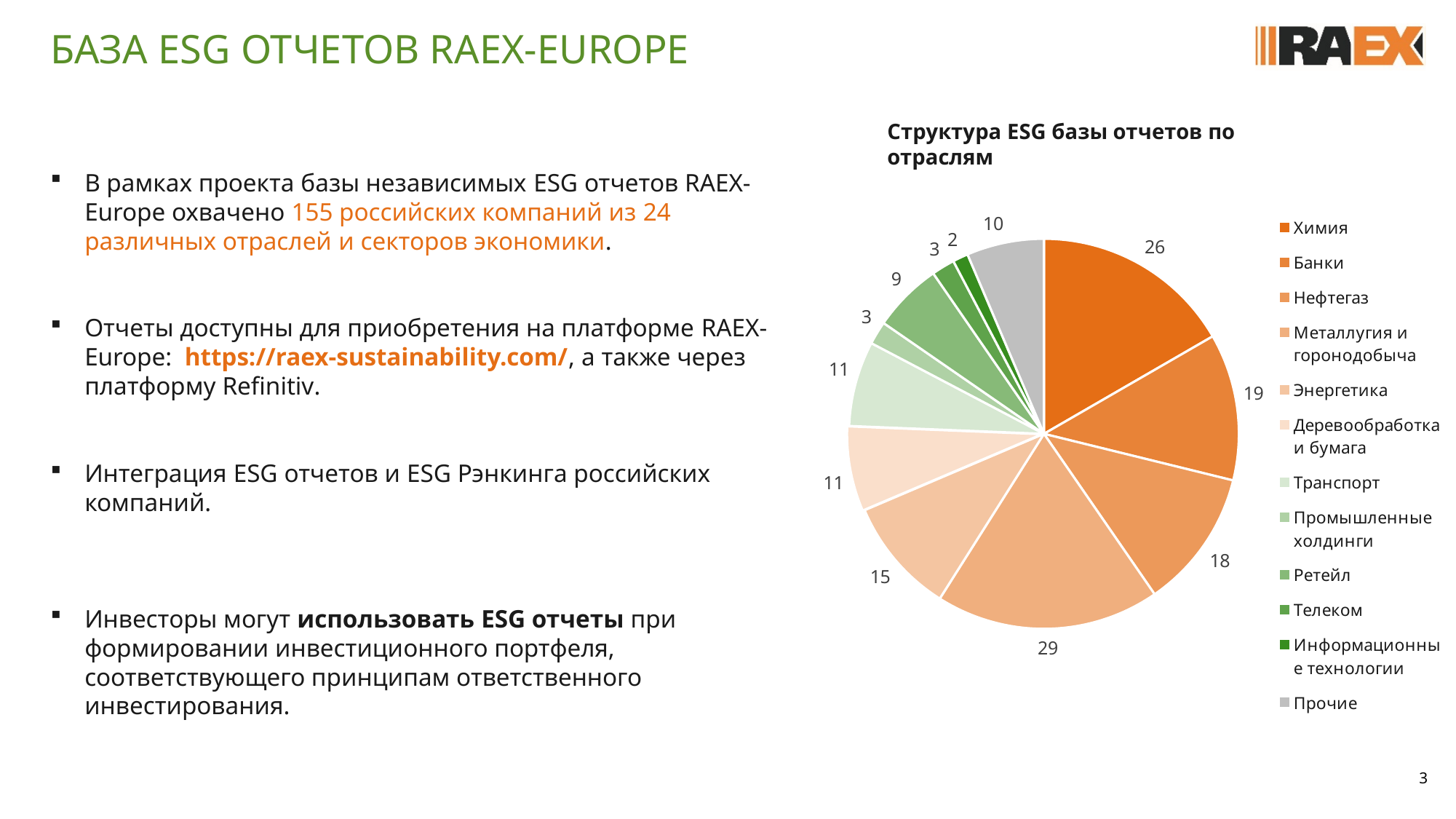
What is the value for Ретейл? 9 How many categories does the pie chart's legend list? 12 What kind of chart is shown on the slide? Pie chart What is the value for Химия? 26 What is the value for Энергетика? 15 What is the title of the chart? Структура ESG базы отчетов по отраслям What is the value for Прочие? 10 What is the difference between the values for Химия and Банки? 7 Which is larger, the value for Банки or the value for Нефтегаз? Банки Which category has the smallest slice of the pie? Информационные технологии What is the value for Металлугия и горонодобыча? 29 Which category has the largest slice of the pie? Металлугия и горонодобыча